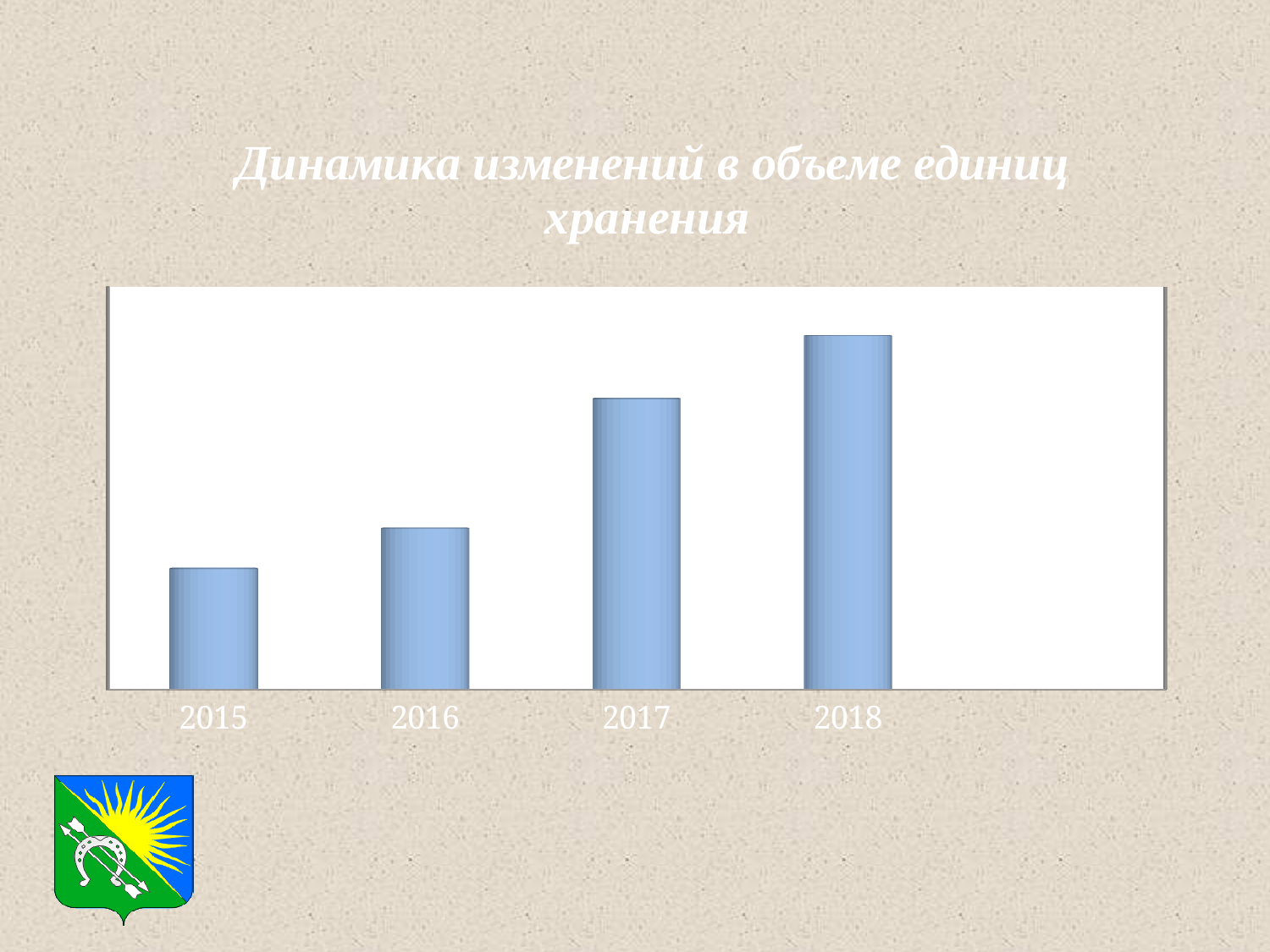
What is the title of the chart on the slide? Динамика изменений в объеме единиц хранения Do the values rise or fall from 2015 to 2018? rise What colour are the bars in the chart? blue Which is larger, the value for 2015 or the value for 2016? 2016 Which year has the highest bar in the chart? 2018 Which year is the first category on the x axis? 2015 What kind of chart is shown on the slide? bar chart How many years are shown on the x axis of the chart? 4 Which year has the lowest bar in the chart? 2015 Which is larger, the value for 2016 or the value for 2017? 2017